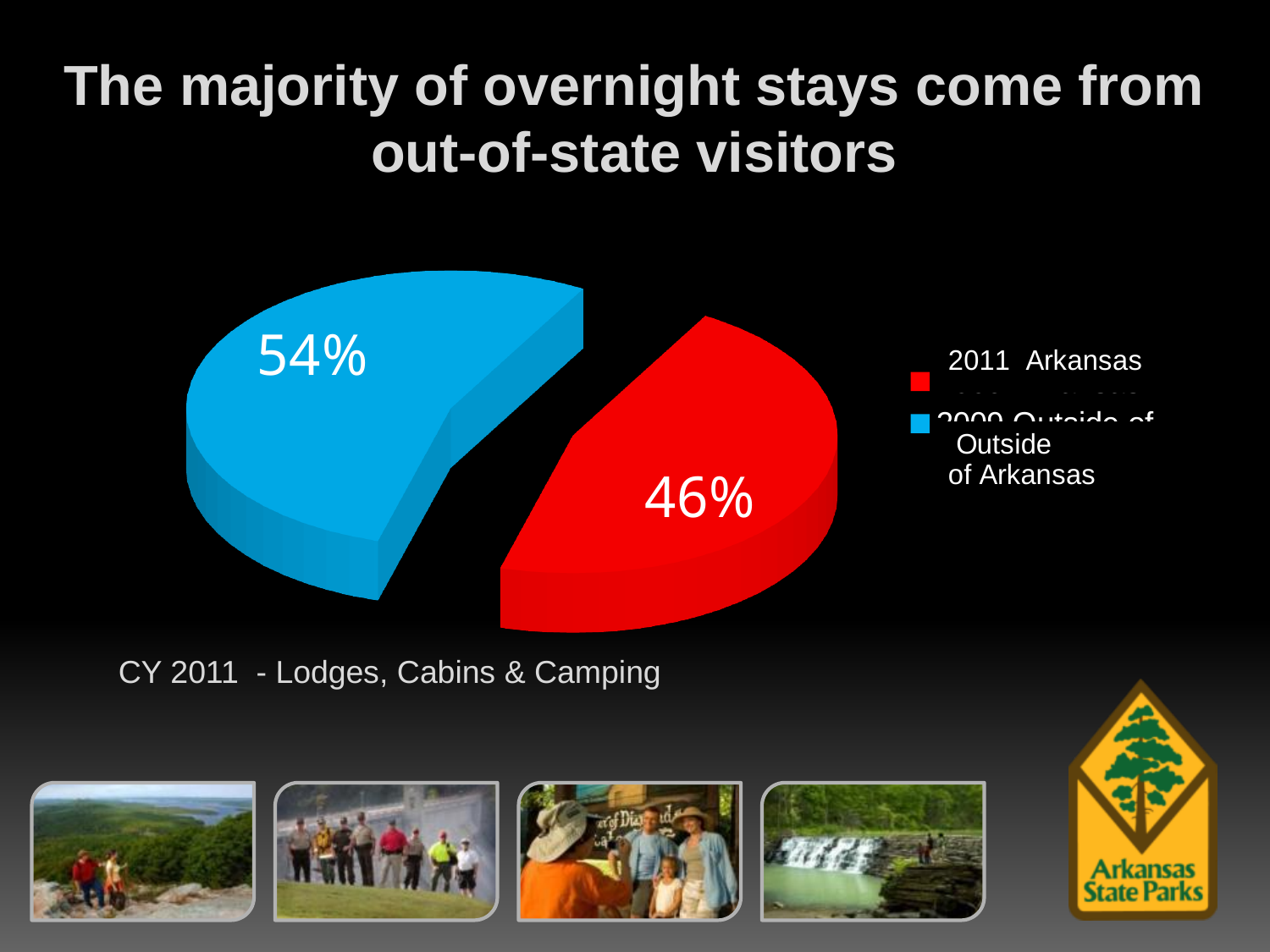
What share of the pie does the red slice (Arkansas) represent? 46% Is the Outside of Arkansas slice larger or smaller than the Arkansas slice? Larger Which slice of the pie is the largest? Outside of Arkansas (54%) Is the share for Arkansas greater or less than 50%? less What is the title of the slide containing the pie chart? The majority of overnight stays come from out-of-state visitors How many slices does the pie chart have? 2 Which colour represents Arkansas in the pie chart? Red By how many percentage points does the Outside of Arkansas share exceed the Arkansas share? 8 percentage points What share of the pie does the blue slice (Outside of Arkansas) represent? 54% Which slice of the pie is the smallest? Arkansas (46%) What kind of chart is shown on the slide? Pie chart